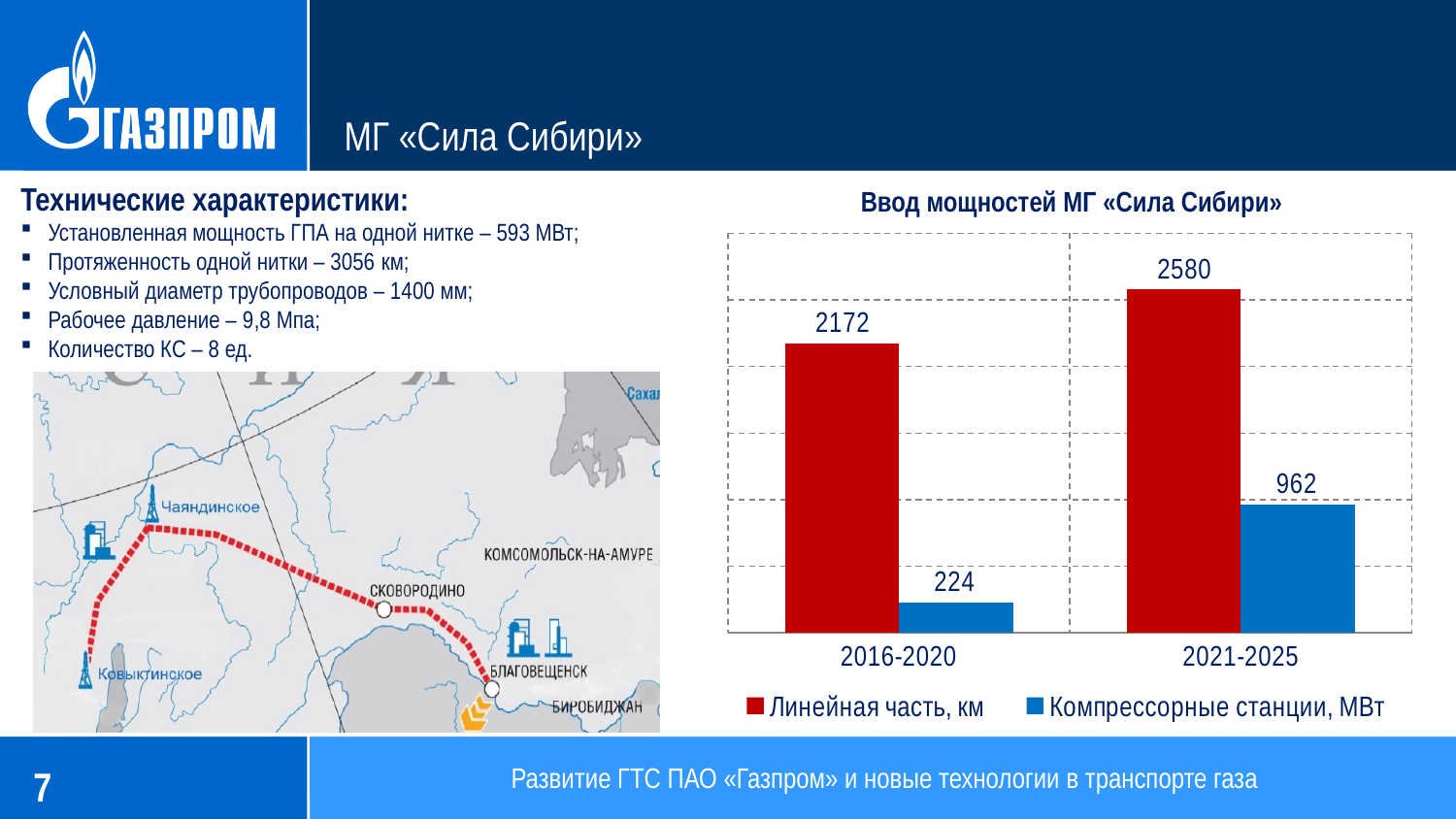
Which period has the higher value for «Линейная часть, км»? 2021-2025 What is the value of «Линейная часть, км» for 2016-2020? 2172 What is the value of «Линейная часть, км» for 2021-2025? 2580 How many periods (categories) are shown on the x axis of the chart? 2 Which is larger: «Компрессорные станции, МВт» for 2021-2025 or «Компрессорные станции, МВт» for 2016-2020? 2021-2025 What is the difference between the «Компрессорные станции, МВт» values for 2021-2025 and 2016-2020? 738 What is the value of «Компрессорные станции, МВт» for 2021-2025? 962 What is the value of «Компрессорные станции, МВт» for 2016-2020? 224 Which period has the lower value for «Компрессорные станции, МВт»? 2016-2020 What is the difference between the «Линейная часть, км» values for 2021-2025 and 2016-2020? 408 What type of chart is shown on the slide? Bar chart How many series does the chart legend list? 2